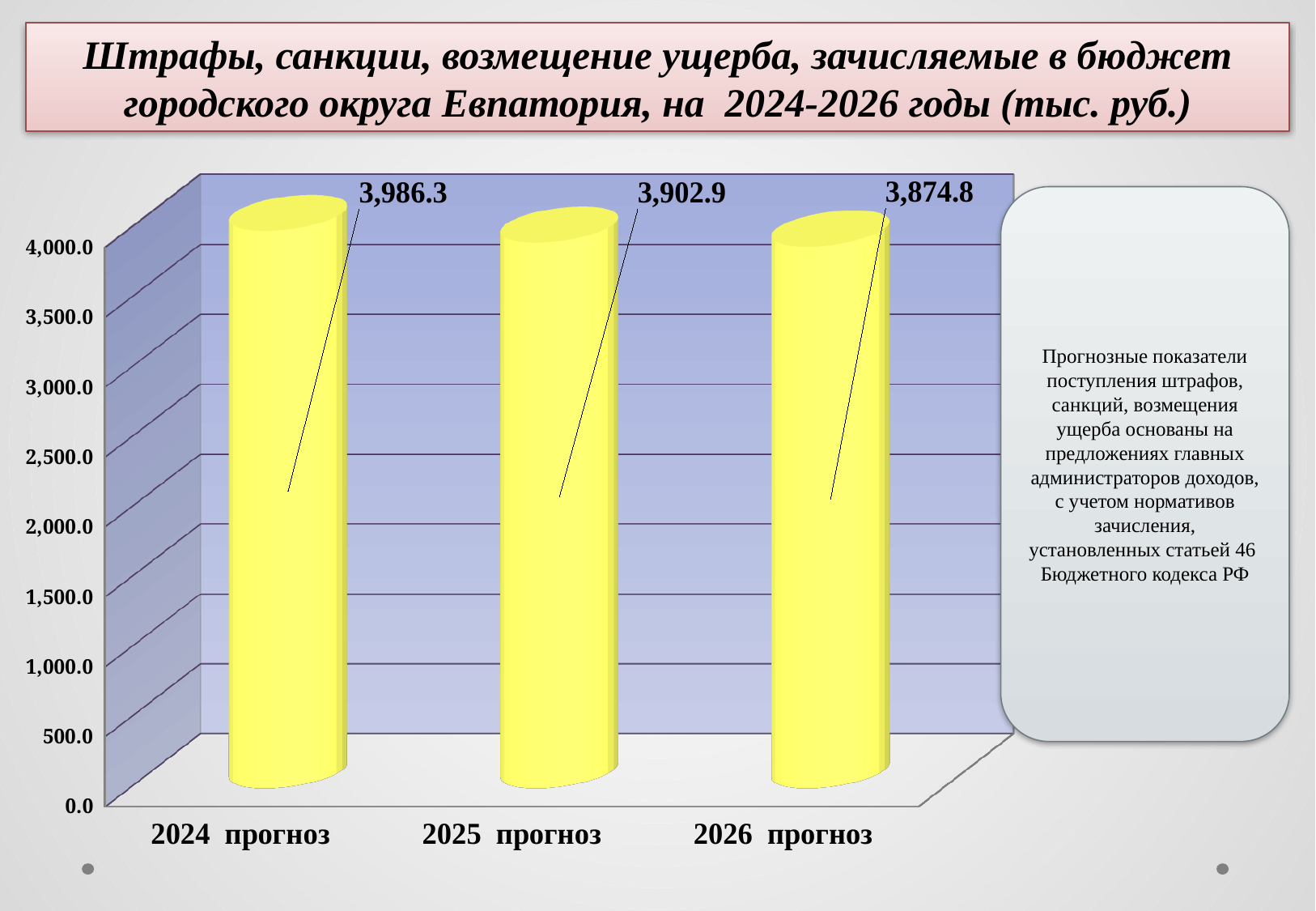
What is the difference between the values for 2024 прогноз and 2026 прогноз? 111.5 How many categories are shown on the x axis? 3 Which is larger, the value for 2025 прогноз or 2026 прогноз? 2025 прогноз What is the value for 2025 прогноз? 3,902.9 What is the value for 2026 прогноз? 3,874.8 Do the values rise or fall from 2024 прогноз to 2026 прогноз? fall Which year has the lowest value? 2026 прогноз Is the value for 2026 прогноз greater or less than 3,500.0? greater Which year has the highest value? 2024 прогноз What is the difference between the values for 2024 прогноз and 2025 прогноз? 83.4 What is the value for 2024 прогноз? 3,986.3 What kind of chart is shown on the slide? bar chart